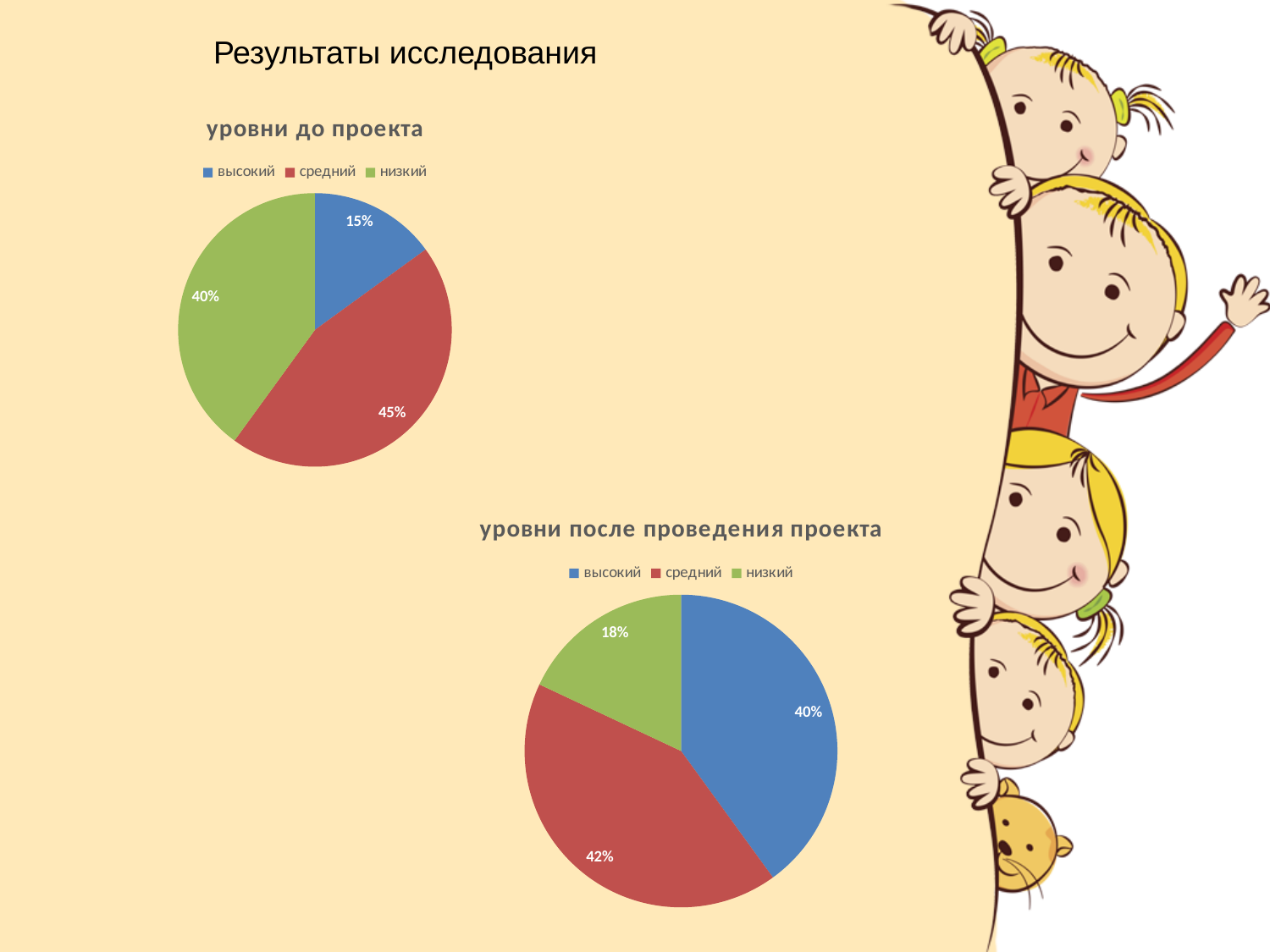
In the chart titled "уровни до проекта", which category has the largest share? средний In the chart titled "уровни после проведения проекта", what is the value for "низкий"? 18% In the chart titled "уровни после проведения проекта", which is larger, "высокий" or "низкий"? высокий In the chart titled "уровни после проведения проекта", what is the value for "высокий"? 40% What kind of chart is the chart titled "уровни до проекта"? pie chart In the chart titled "уровни после проведения проекта", what is the difference between "средний" and "низкий"? 24% How many categories does the legend of the chart titled "уровни после проведения проекта" list? 3 In the chart titled "уровни до проекта", what is the difference between "низкий" and "высокий"? 25% In the chart titled "уровни до проекта", what is the value for "высокий"? 15% In the chart titled "уровни до проекта", what is the value for "средний"? 45% In the chart titled "уровни до проекта", which category has the smallest share? высокий In the chart titled "уровни после проведения проекта", which category has the smallest share? низкий